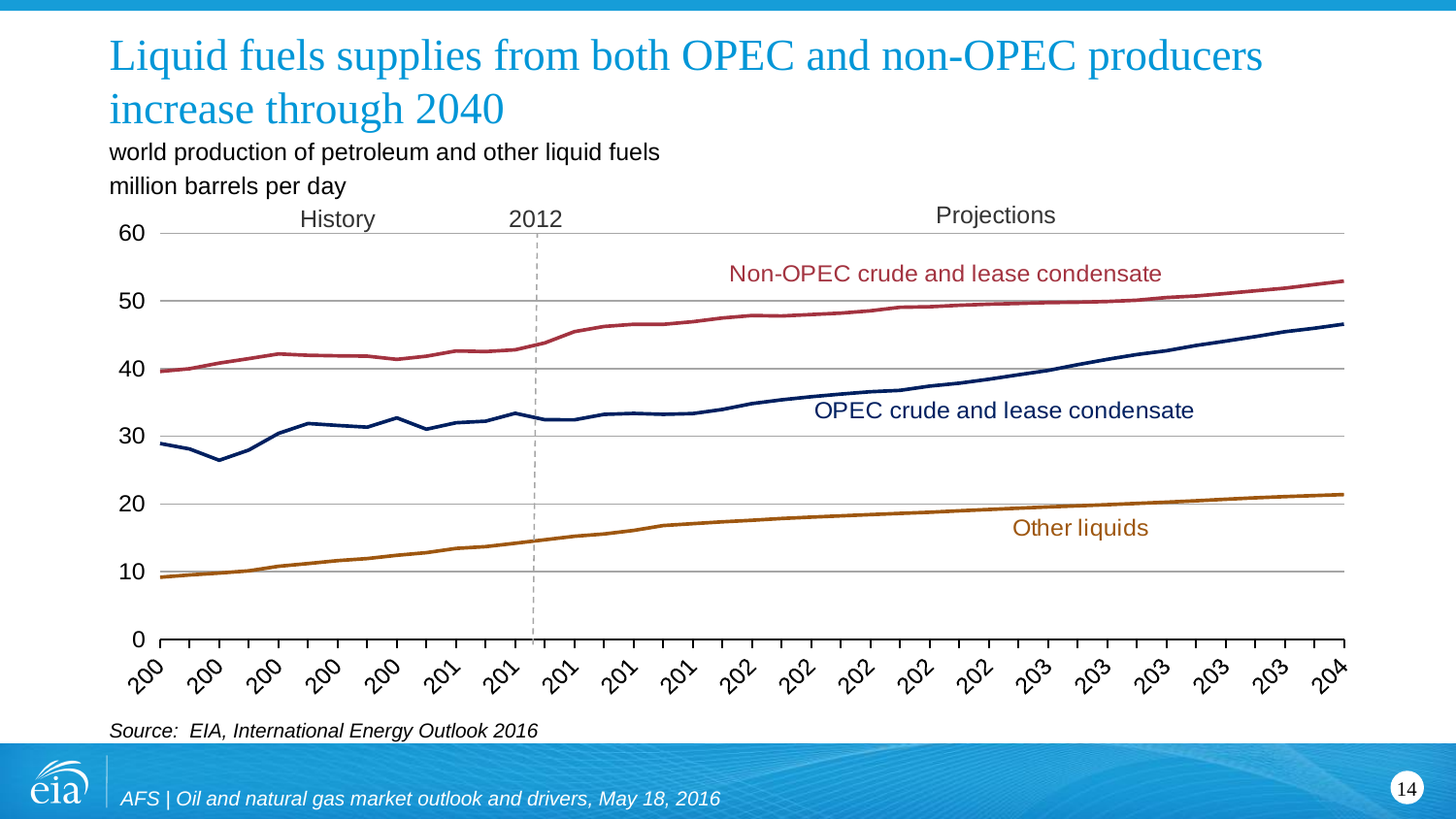
What unit is the y axis measured in? million barrels per day Which series has the lowest values throughout the chart? Other liquids Which is larger at the 2012 dashed line: OPEC crude and lease condensate or Other liquids? OPEC crude and lease condensate Is the value for Other liquids at the 2012 dashed line greater or less than 20? less Is the value for Non-OPEC crude and lease condensate at the 2012 dashed line greater or less than 40? greater Is the value for OPEC crude and lease condensate at the right end of the chart greater or less than 50? less What kind of chart is shown on the slide? line chart Does the Other liquids series rise or fall across the projection period? rise Which series has the highest values throughout the chart? Non-OPEC crude and lease condensate How many series are plotted on the chart? 3